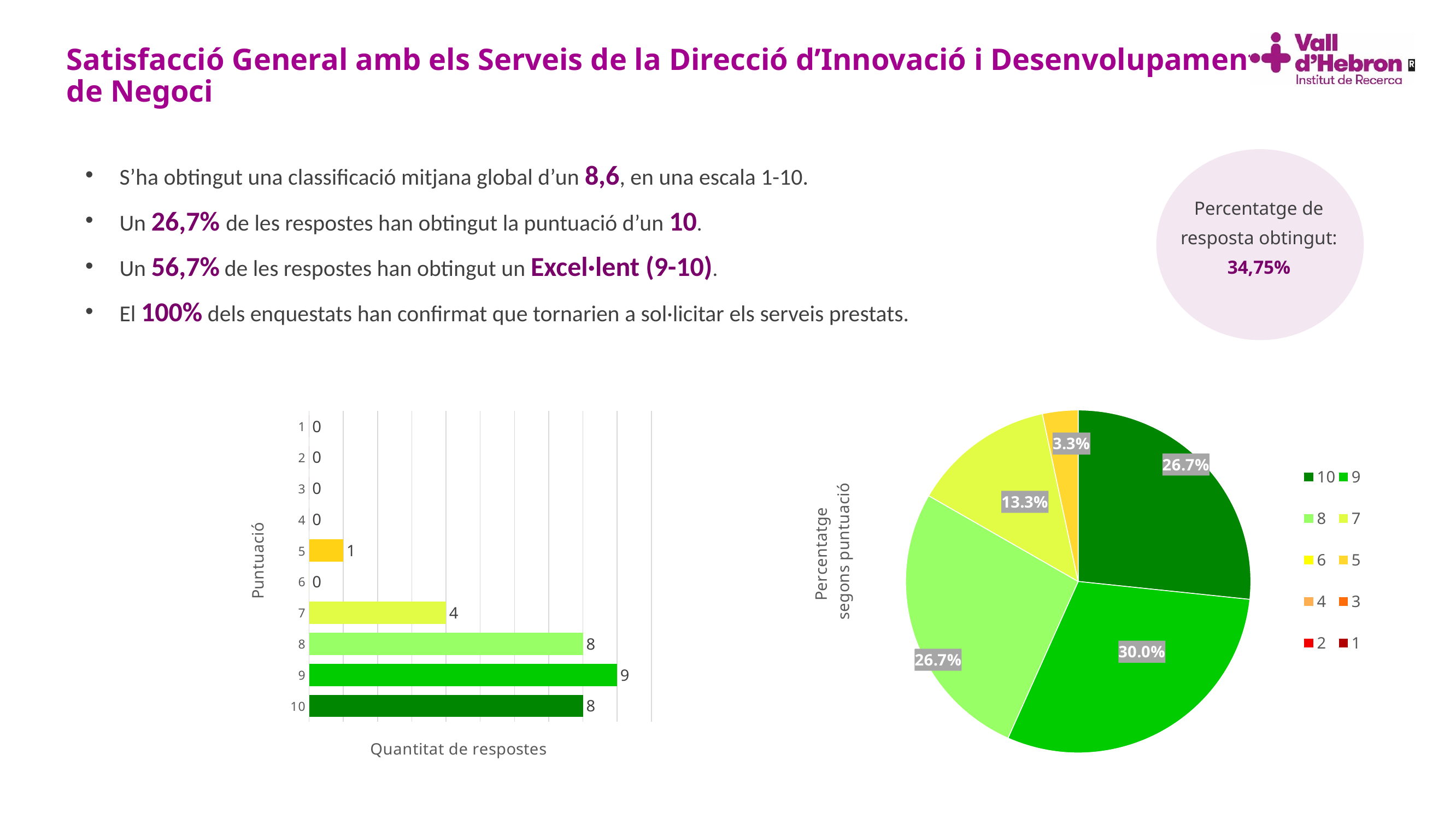
In the bar chart on the left, which has more responses, score 8 or score 5? 8 What is the axis title along the horizontal axis of the bar chart on the left? Quantitat de respostes In the pie chart on the right, what percentage share does score 9 have? 30.0% In the bar chart on the left, how many responses gave a score of 9? 9 In the bar chart on the left, how many responses gave a score of 7? 4 In the bar chart on the left, what is the difference between the number of responses for score 9 and score 7? 5 In the pie chart on the right, which score has the smallest labelled slice? 5 In the pie chart on the right, what percentage share does score 7 have? 13.3% How many entries does the legend of the pie chart on the right list? 10 What type of chart is the chart on the left of the slide? bar chart In the bar chart on the left, which score received the most responses? 9 In the bar chart on the left, how many score categories are shown on the vertical axis? 10